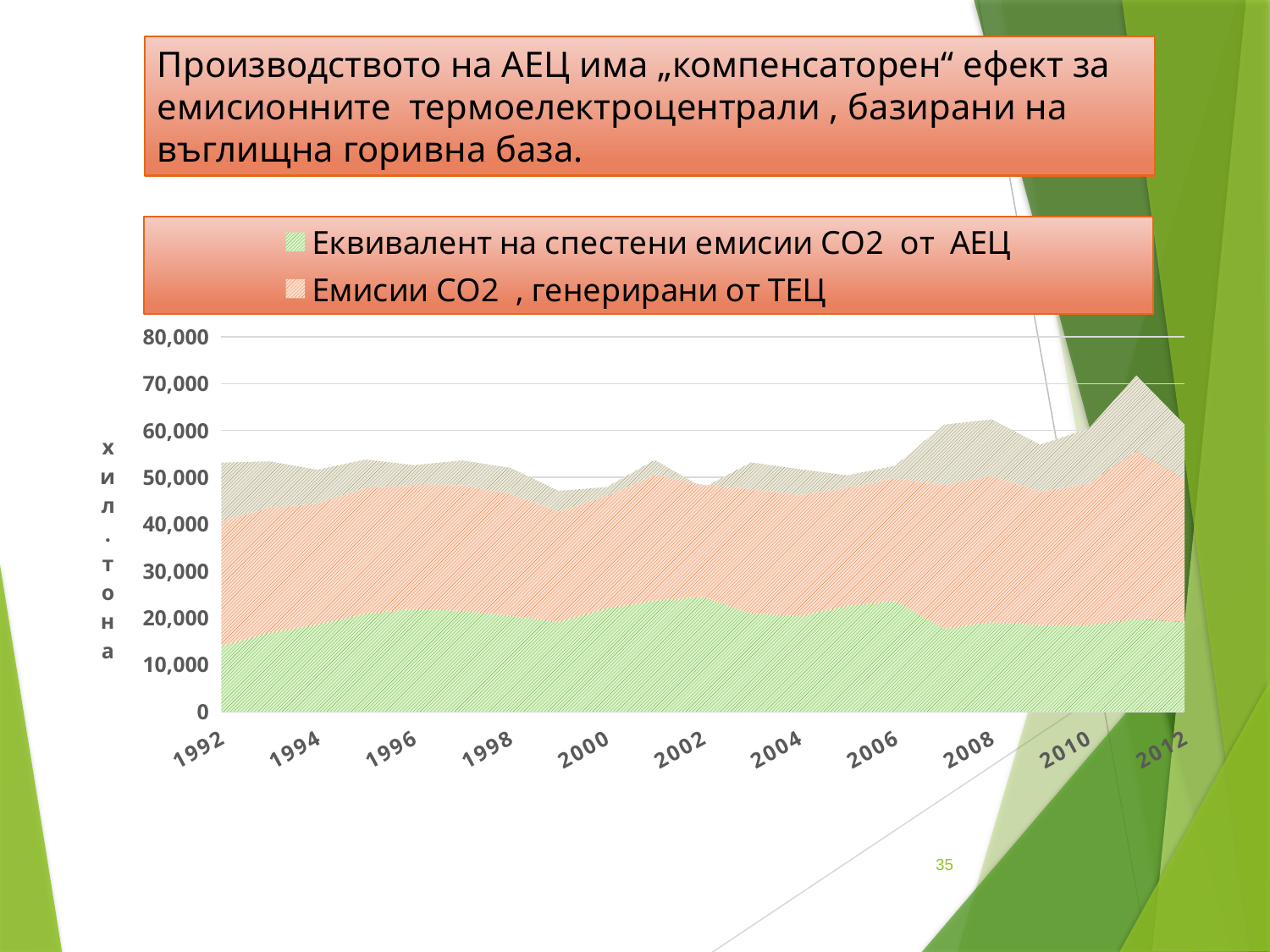
What is the highest value shown on the vertical axis? 80,000 What is the last year shown on the horizontal axis? 2012 Which series is shown in green in the chart? Еквивалент на спестени емисии CO2 от АЕЦ What kind of chart is shown on the slide? stacked area chart What is the unit label on the vertical axis of the chart? хил. тона Does the value for Еквивалент на спестени емисии CO2 от АЕЦ rise or fall from 1992 to 1996? rise How many year labels are shown on the horizontal axis? 11 What is the first year shown on the horizontal axis? 1992 How many series does the legend list? 2 Is the value for Еквивалент на спестени емисии CO2 от АЕЦ in 1992 greater or less than 20,000? less Is the stacked total of both series in 2000 greater or less than 50,000? less